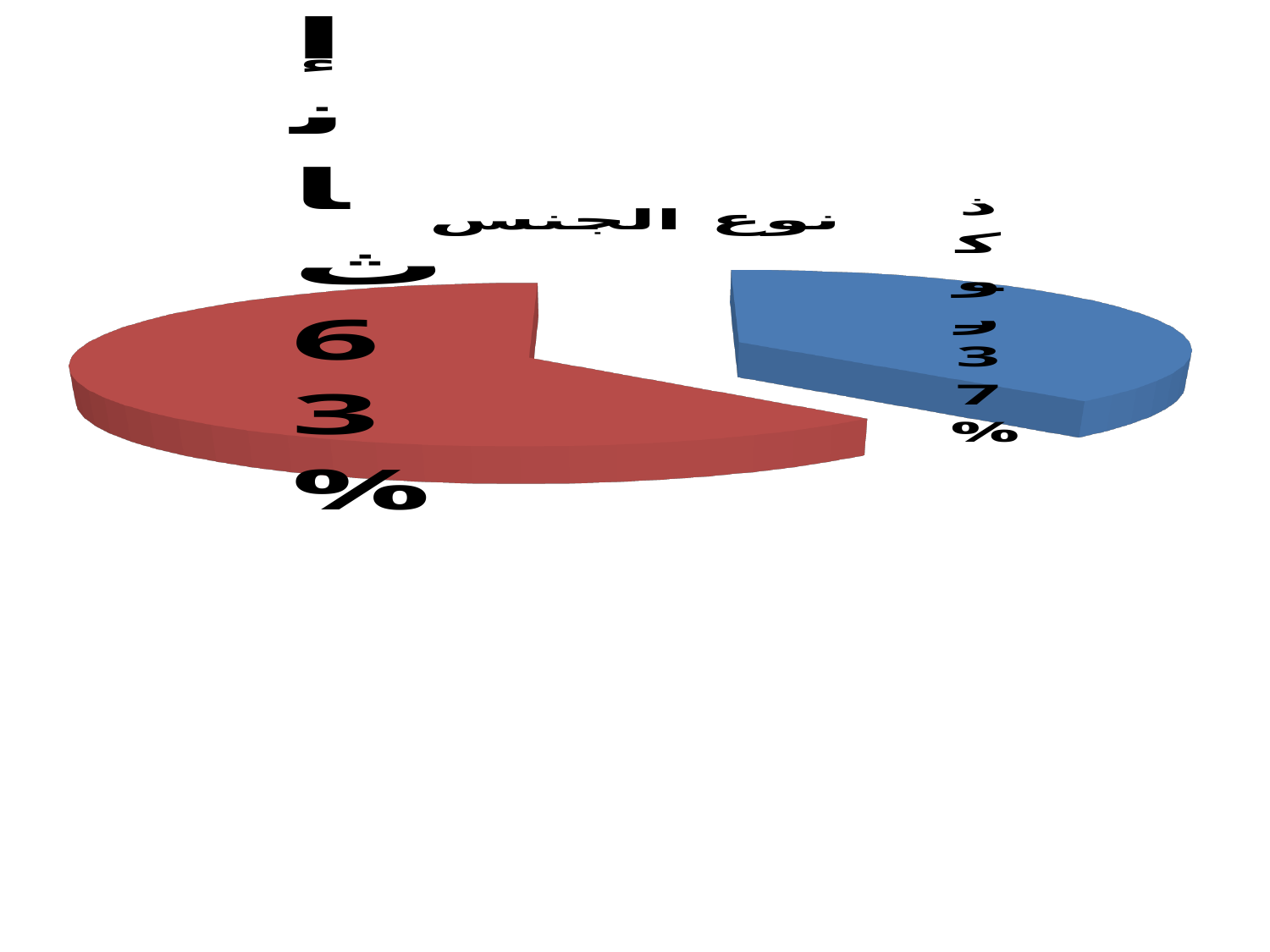
What colour is the slice representing إناث? red Which is larger, the share for إناث or the share for ذكور? إناث What is the difference in percentage points between the إناث slice and the ذكور slice? 26 Which category has the smallest share of the pie? ذكور What percentage is shown for إناث (females)? 63% What is the combined percentage of the two slices? 100% How many slices does the pie chart have? 2 What type of chart is shown on the slide? pie chart What percentage is shown for ذكور (males)? 37% Which category has the largest share of the pie? إناث What is the title of the chart? نوع الجنس